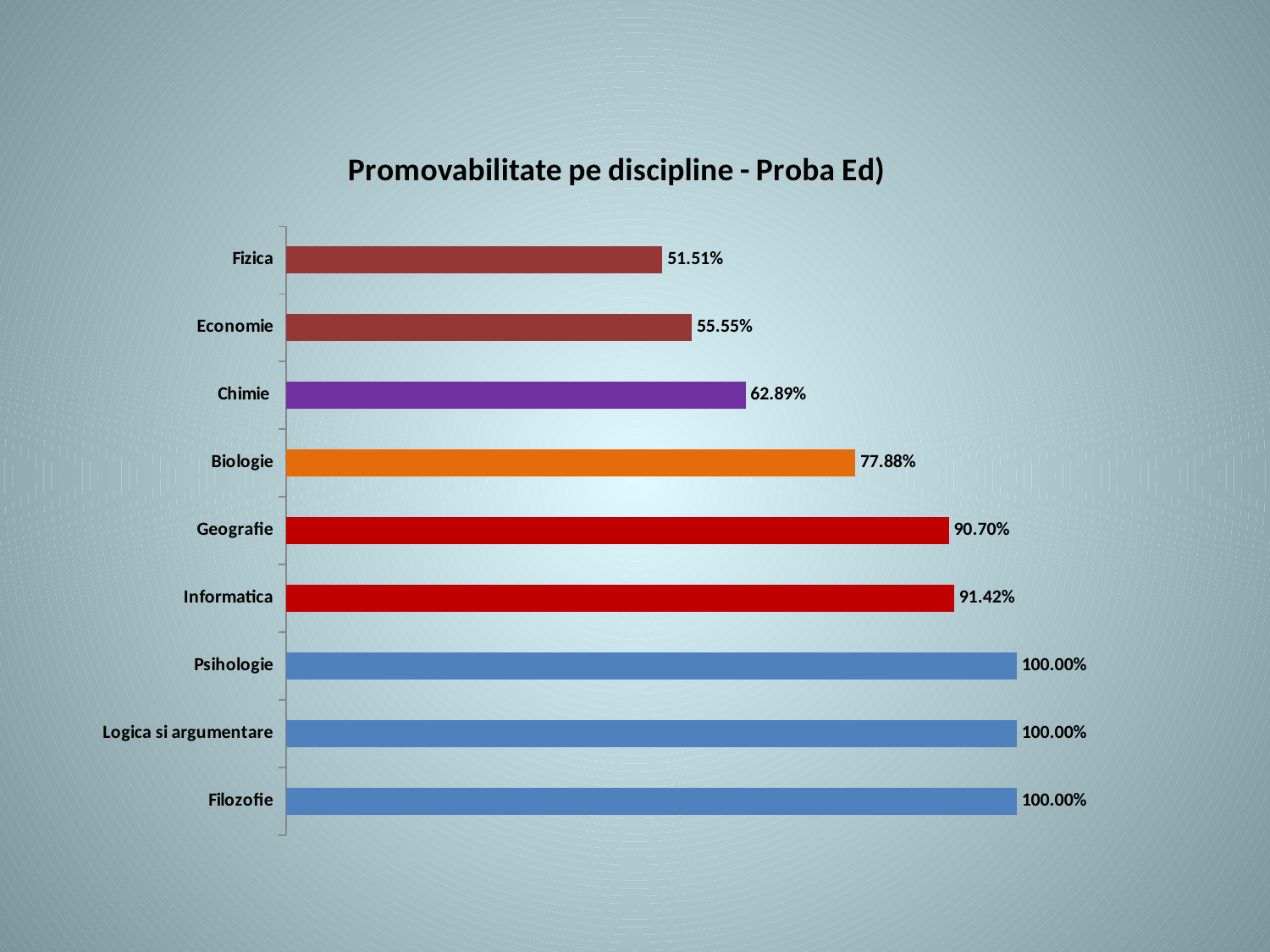
How many disciplines have a value of 100.00%? 3 What is the title of the chart? Promovabilitate pe discipline - Proba Ed) Which is larger, the value for Biologie or the value for Chimie? Biologie What kind of chart is this? Bar chart What is the difference between the values for Economie and Fizica? 4.04% What is the value for Fizica? 51.51% What is the value for Chimie? 62.89% How many disciplines are shown in the chart? 9 Which discipline has the lowest value? Fizica What is the difference between the values for Informatica and Geografie? 0.72% What is the value for Biologie? 77.88% What is the value for Informatica? 91.42%